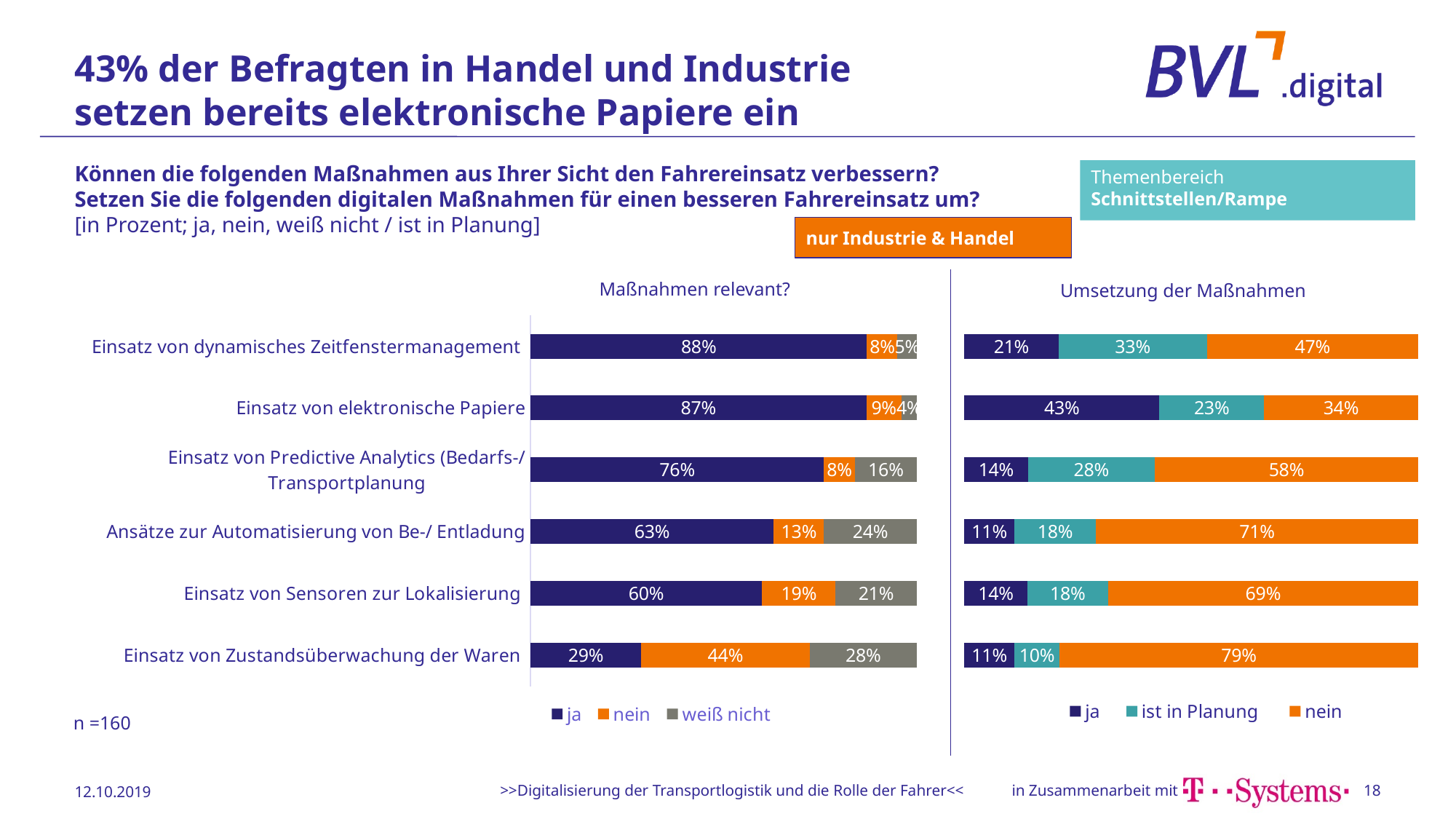
What are the legend entries of the 'Maßnahmen relevant?' chart? ja, nein, weiß nicht In the 'Maßnahmen relevant?' chart, what is the 'ja' value for 'Einsatz von elektronische Papiere'? 87% How many series does the legend of the 'Umsetzung der Maßnahmen' chart list? 3 What kind of chart is the 'Umsetzung der Maßnahmen' chart? Stacked bar chart In the 'Maßnahmen relevant?' chart, what is the difference between the 'nein' values for 'Einsatz von Zustandsüberwachung der Waren' and 'Einsatz von Sensoren zur Lokalisierung'? 25% In the 'Maßnahmen relevant?' chart, which category has the highest 'ja' value? Einsatz von dynamisches Zeitfenstermanagement In the 'Maßnahmen relevant?' chart, what is the total of the stacked bar for 'Ansätze zur Automatisierung von Be-/ Entladung'? 100% In the 'Umsetzung der Maßnahmen' chart, what is the 'nein' value for 'Einsatz von Zustandsüberwachung der Waren'? 79% In the 'Umsetzung der Maßnahmen' chart, which is larger: the 'ja' value for 'Einsatz von elektronische Papiere' or the 'ja' value for 'Einsatz von dynamisches Zeitfenstermanagement'? Einsatz von elektronische Papiere In the 'Umsetzung der Maßnahmen' chart, what is the 'ist in Planung' value for 'Einsatz von dynamisches Zeitfenstermanagement'? 33% In the 'Umsetzung der Maßnahmen' chart, which category has the lowest 'nein' value? Einsatz von elektronische Papiere How many categories are shown in the 'Maßnahmen relevant?' chart? 6